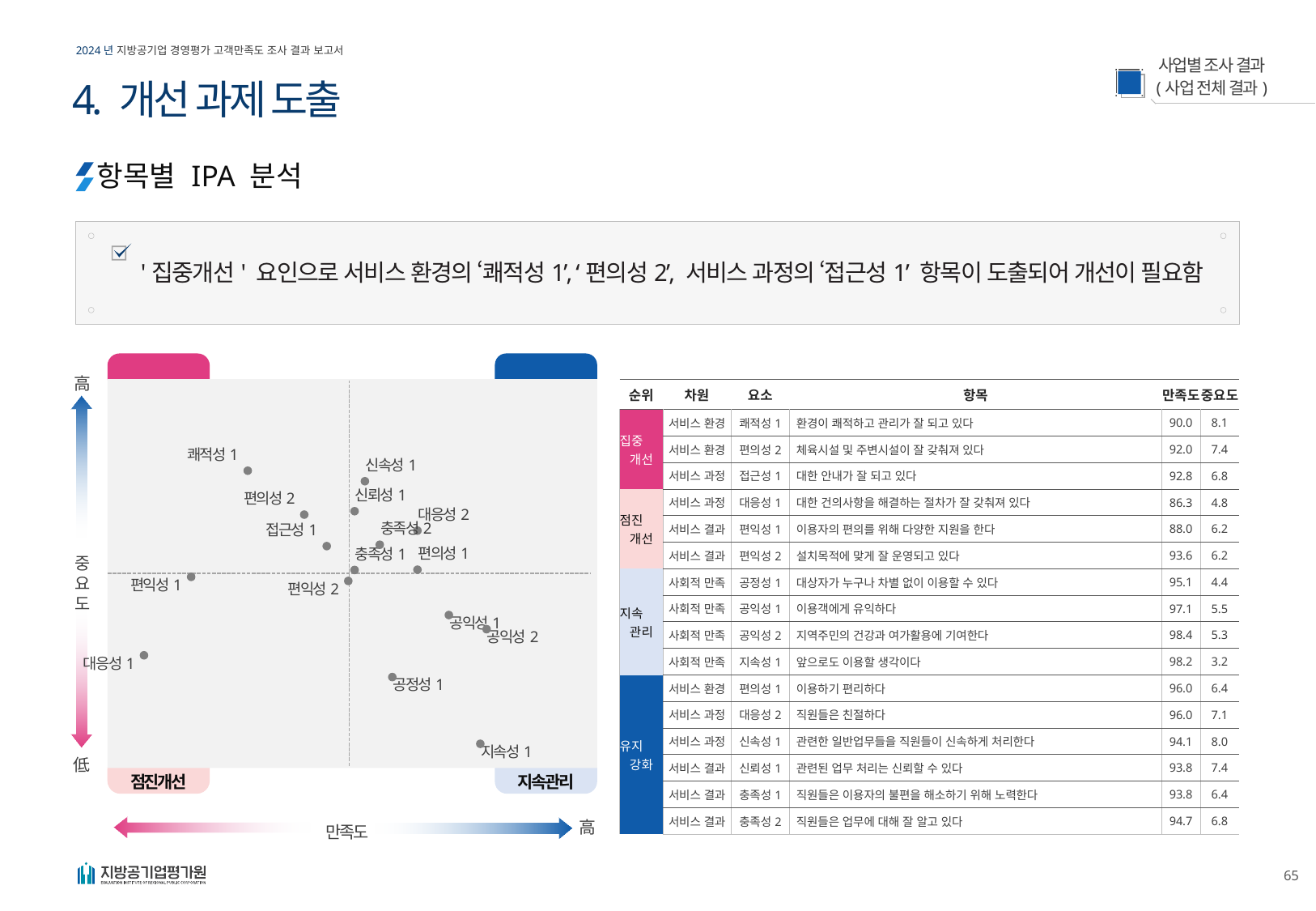
On the IPA scatter chart, which point has the lowest importance (중요도)? 지속성 1 On the IPA scatter chart, which has the higher importance: 쾌적성 1 or 지속성 1? 쾌적성 1 According to the table next to the IPA chart, what is the satisfaction (만족도) value for 쾌적성 1? 90.0 What label is shown in the bottom-right quadrant of the IPA scatter chart? 지속관리 What kind of chart is the IPA analysis chart on the left of the slide? scatter chart Using the table values, what is the difference in importance (중요도) between 쾌적성 1 (8.1) and 지속성 1 (3.2)? 4.9 On the IPA scatter chart, which point has the lowest satisfaction (만족도), i.e. is furthest left? 대응성 1 How many labelled points are plotted on the IPA scatter chart? 16 According to the table next to the IPA chart, what is the importance (중요도) value for 지속성 1? 3.2 On the IPA scatter chart, which points fall in the upper-left quadrant (high importance, low satisfaction)? 쾌적성 1, 편의성 2, 접근성 1 On the IPA scatter chart, which has the higher satisfaction: 공정성 1 or 대응성 1? 공정성 1 What is the label of the horizontal axis of the IPA scatter chart? 만족도